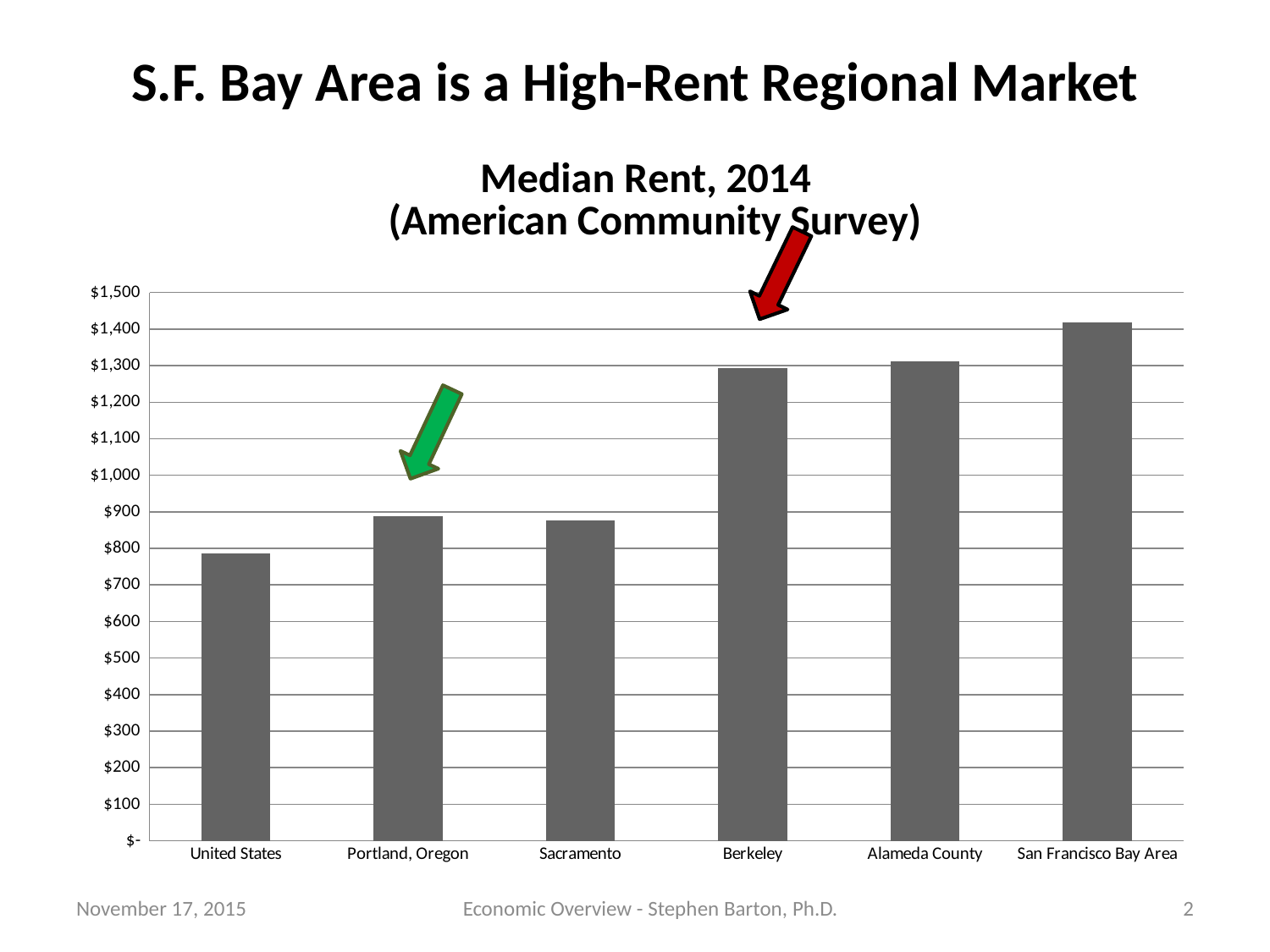
Is the value for San Francisco Bay Area greater or less than $1,300? greater Is the value for Berkeley greater or less than $1,200? greater Is the value for Alameda County greater or less than $1,400? less Which category has the highest median rent? San Francisco Bay Area How many categories are shown on the x axis of the chart? 6 What is the title of the chart? Median Rent, 2014 (American Community Survey) Which has a higher median rent, Berkeley or Sacramento? Berkeley What type of chart is shown on the slide? bar chart Which category has the lowest median rent? United States